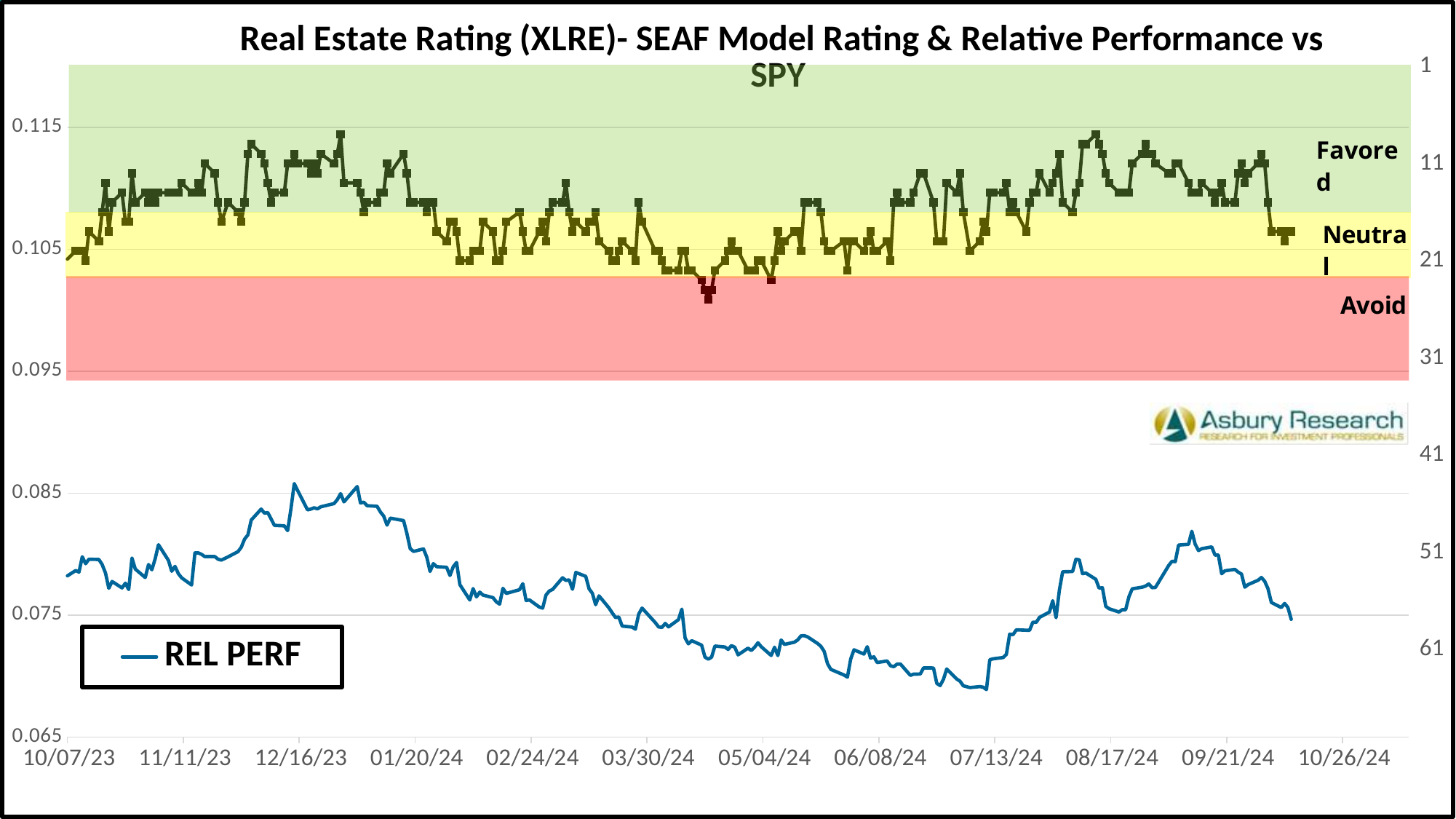
How many series does the legend list? 1 Does the REL PERF line rise or fall between 12/16/23 and 03/30/24? fall In which shaded rating zone do the final points of the SEAF model rating line sit, in October 2024? Neutral What kind of chart is shown on the slide? line chart In which shaded rating zone does the SEAF model rating line sit at its lowest point, around mid-April 2024? Avoid Does the REL PERF line rise or fall between 07/13/24 and 08/17/24? rise Is the REL PERF value at 10/07/23 greater or less than 0.085? less What series name appears in the legend? REL PERF Is the REL PERF value at 10/07/23 greater or less than 0.075? greater Is the lowest REL PERF value, reached around 07/13/24, greater or less than 0.075? less What is the title of the chart? Real Estate Rating (XLRE)- SEAF Model Rating & Relative Performance vs SPY